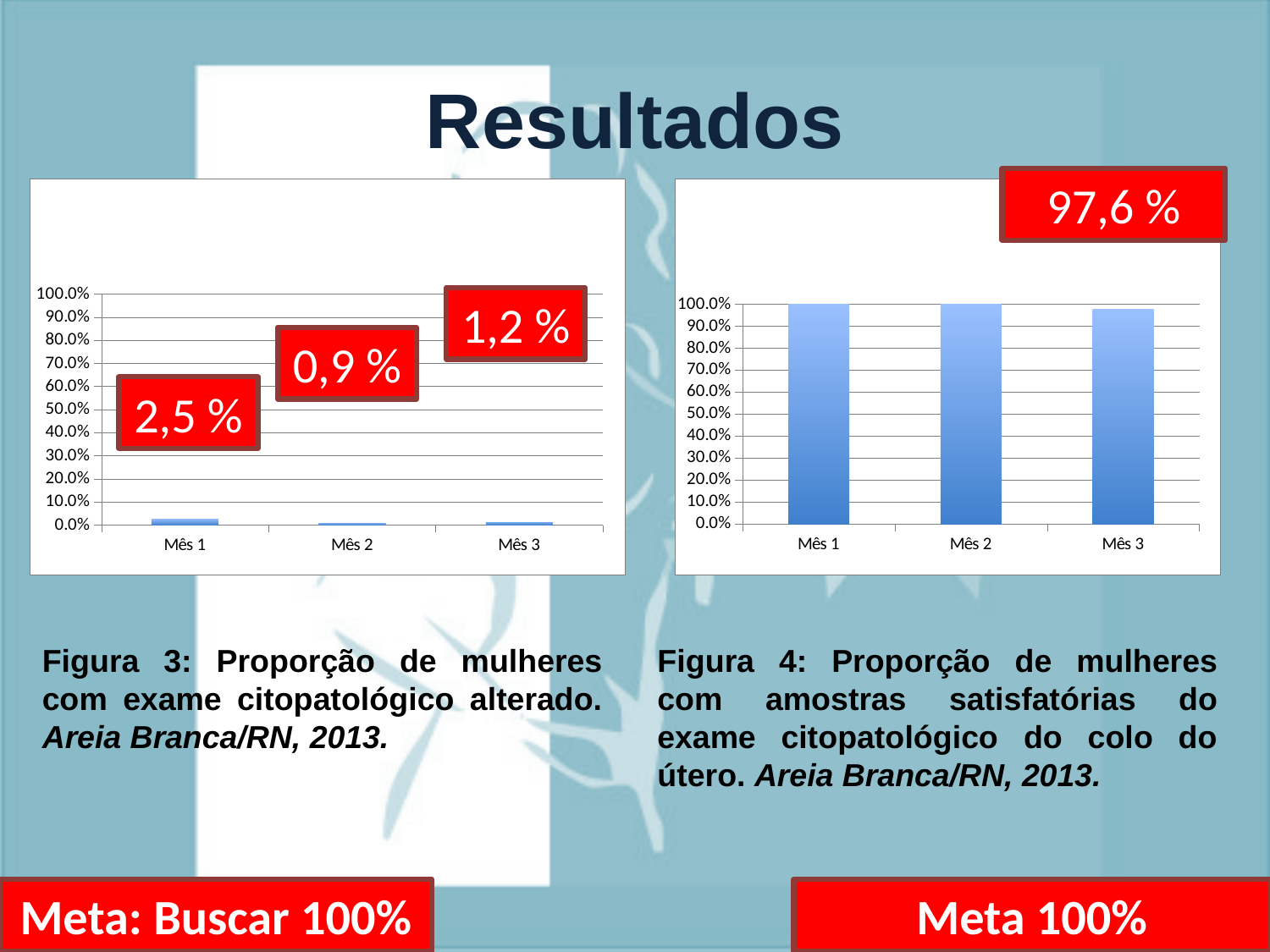
In the left chart (Figura 3), what is the difference between the values for Mês 1 and Mês 2? 1,6 % In the right chart (Figura 4), what is the value for Mês 3? 97,6 % In the left chart (Figura 3), which month has the lowest value? Mês 2 In the left chart (Figura 3), is the value for Mês 1 larger or smaller than the value for Mês 3? larger In the left chart (Figura 3), which month has the highest value? Mês 1 In the left chart (Figura 3), what is the value for Mês 2? 0,9 % What kind of chart is the right chart (Figura 4)? Bar chart In the left chart (Figura 3), what is the value for Mês 3? 1,2 % In the left chart (Figura 3), how many months are shown on the x axis? 3 In the right chart (Figura 4), is the value for Mês 1 greater or less than 90.0%? greater In the left chart (Figura 3), what is the value for Mês 1? 2,5 % In the right chart (Figura 4), which month has the lowest value? Mês 3